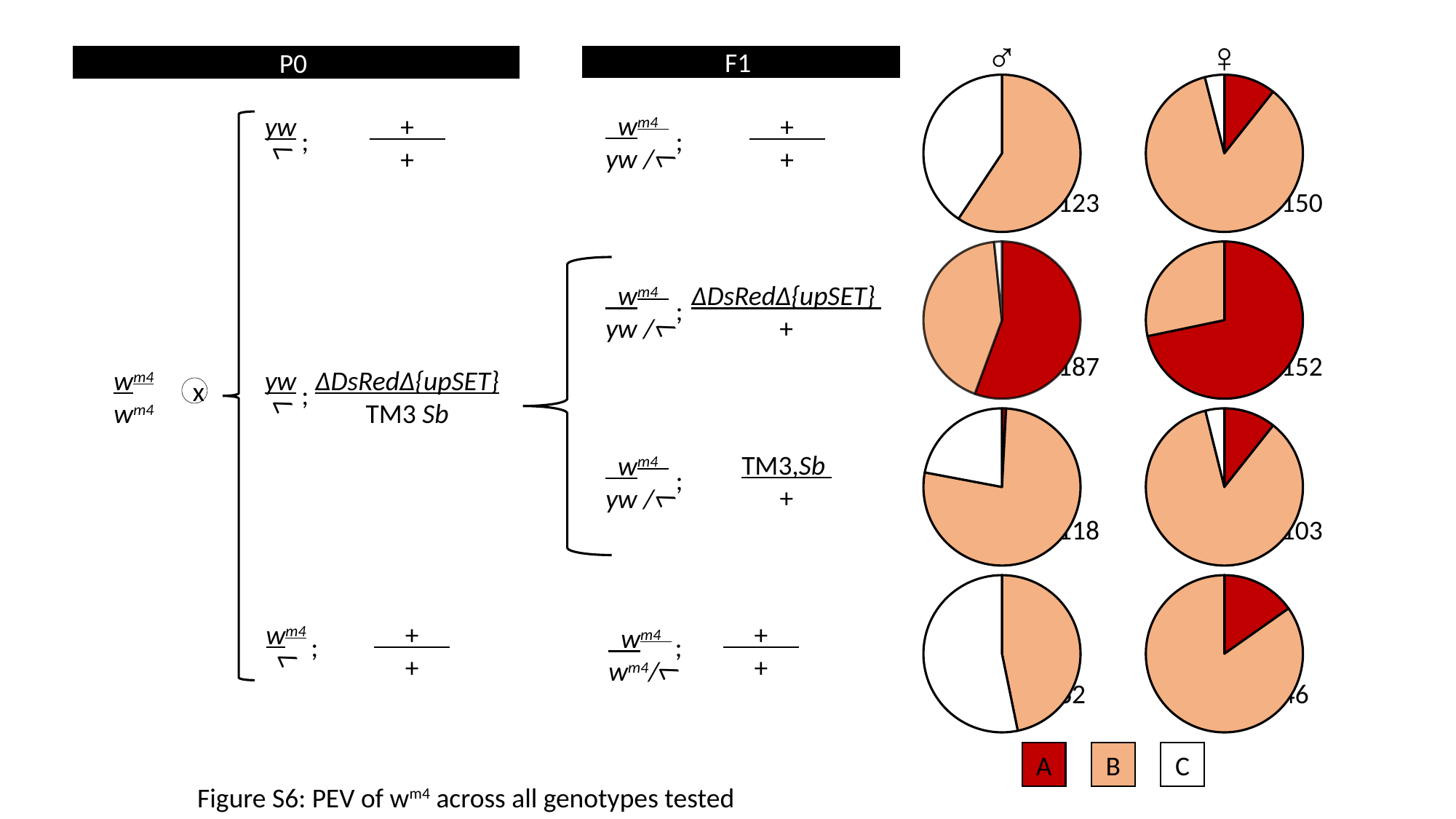
What number is printed next to the male (♂) pie chart in the top row? 123 How many pie charts are shown on the slide? 8 What number is printed next to the male (♂) pie chart in the second row? 187 What kind of charts are shown on the right side of the slide? pie charts What number is printed next to the male (♂) pie chart in the third row? 118 What number is printed next to the female (♀) pie chart in the third row? 103 In the female (♀) pie chart in the second row, which slice is larger, A or B? A Which pie chart has the largest number printed next to it among the top three rows? the male (♂) pie chart in the second row (187) What number is printed next to the female (♀) pie chart in the second row? 152 How many categories does the legend list for the pie charts? 3 What number is printed next to the female (♀) pie chart in the top row? 150 What are the legend labels for the pie charts? A, B, C